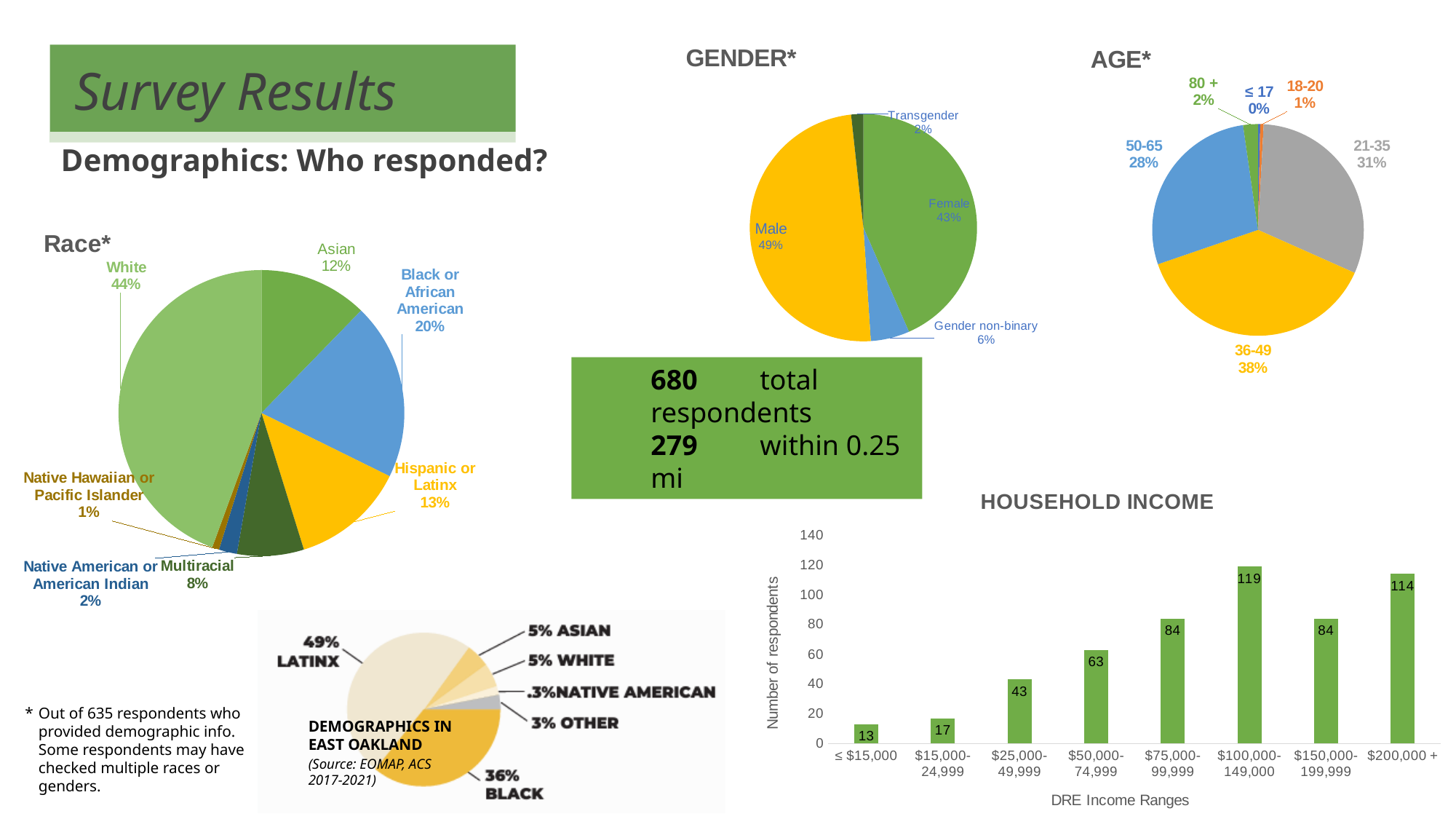
In the Age pie chart, what percentage of respondents are aged 50-65? 28% How many race categories are shown in the Race pie chart? 7 In the Race pie chart, what percentage of respondents are White? 44% In the Gender pie chart, what percentage of respondents are Male? 49% In the Gender pie chart, which is larger, the Female share or the Male share? Male In the Race pie chart, which race has the largest share? White In the Age pie chart, which age group has the largest share? 36-49 In the Household Income bar chart, what is the difference between the number of respondents in the $100,000-149,000 range and the $200,000 + range? 5 In the Race pie chart, what is the difference between the Black or African American share and the Hispanic or Latinx share? 7% In the Household Income bar chart, which income range has the fewest respondents? ≤ $15,000 In the Household Income bar chart, how many respondents are in the $100,000-149,000 range? 119 How many income ranges are shown in the Household Income bar chart? 8